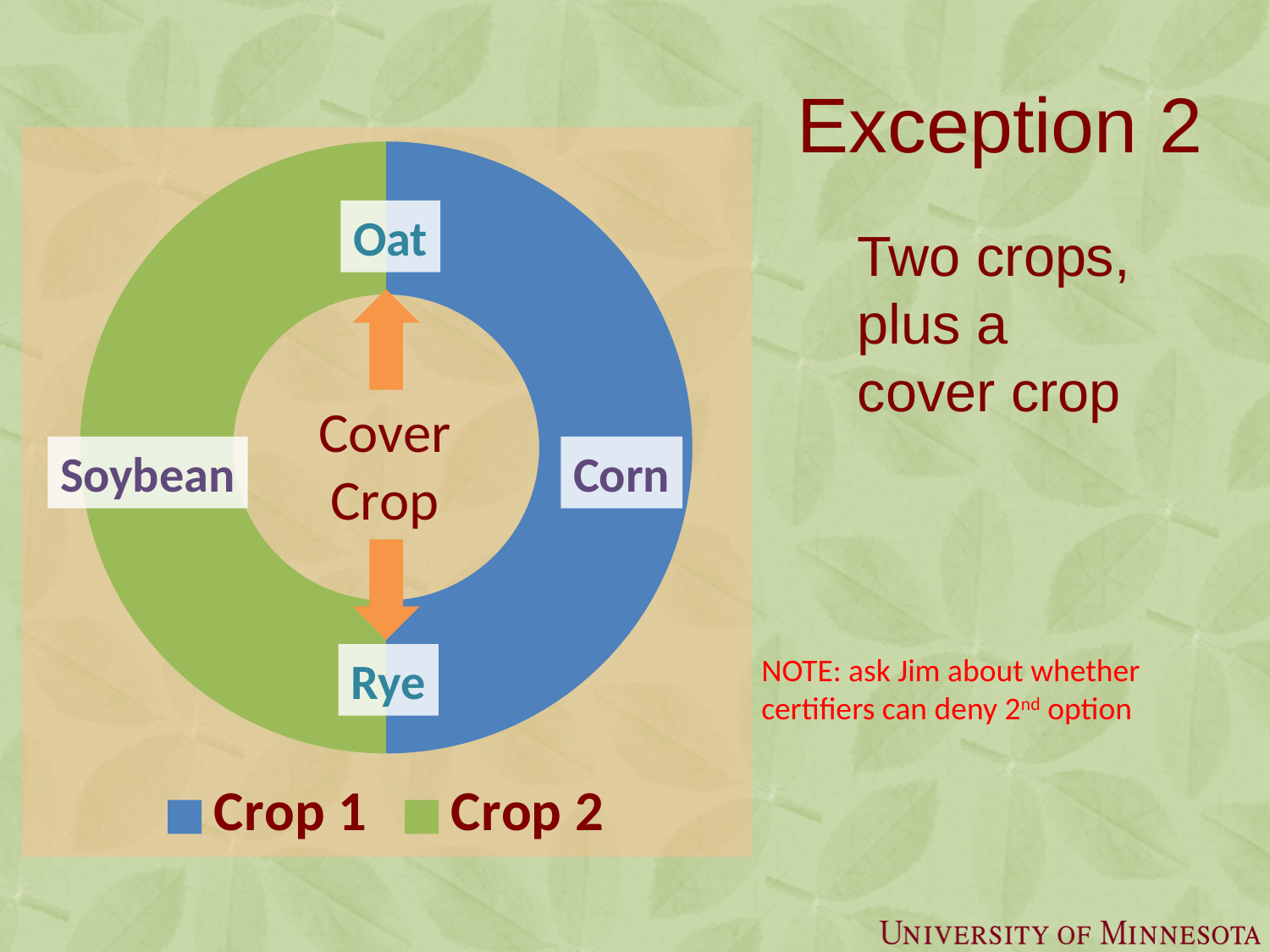
What colour is the Crop 2 slice in the chart? Green What are the two legend entries of the chart? Crop 1 and Crop 2 Which crop name is labelled on the blue (Crop 1) slice? Corn How many slices does the doughnut chart have? 2 What kind of chart is shown on the slide? Doughnut chart What text appears in the centre of the doughnut chart? Cover Crop How many entries does the chart legend list? 2 What colour is the Crop 1 slice in the chart? Blue Which crop name is labelled on the green (Crop 2) slice? Soybean